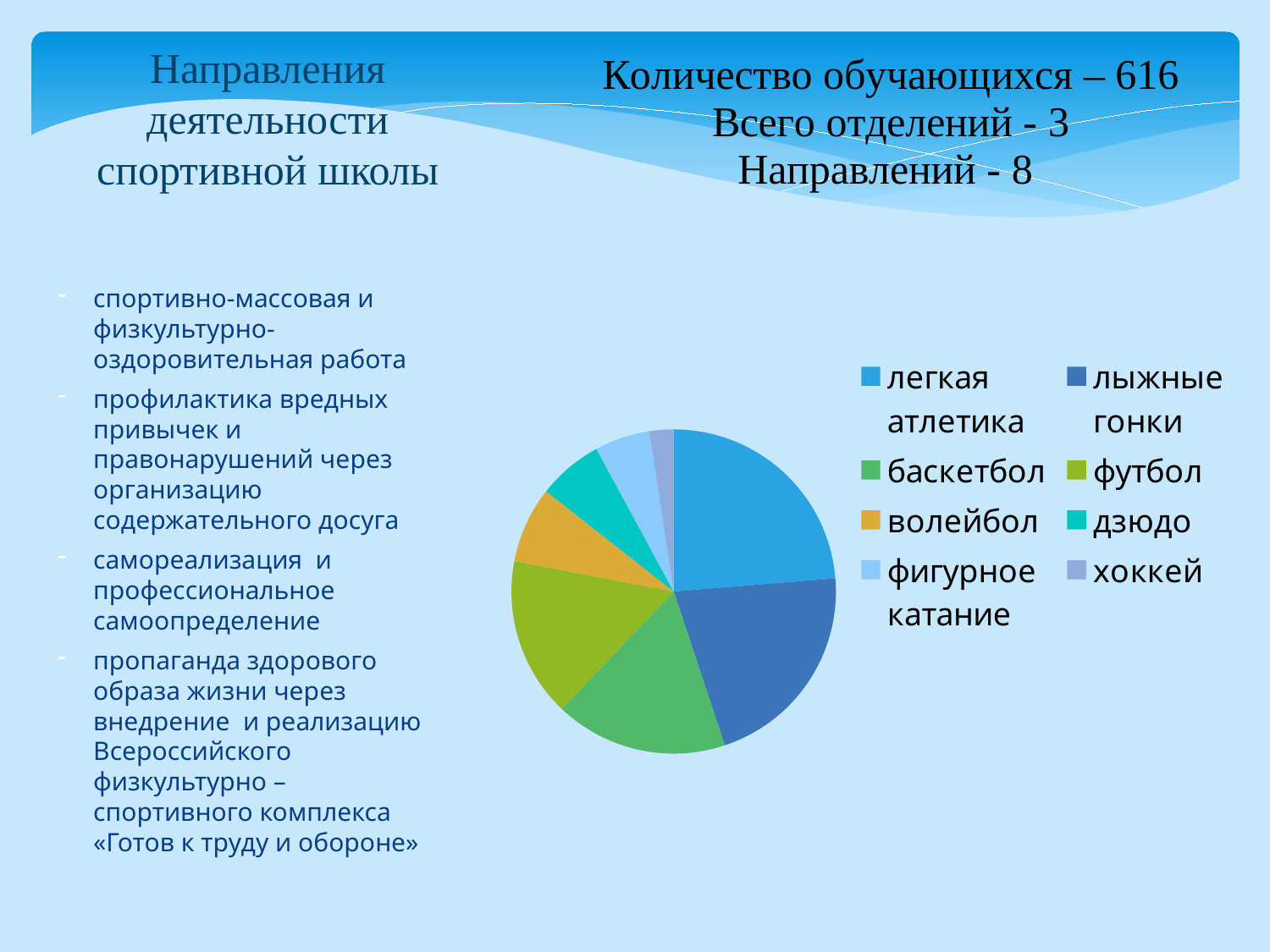
How many categories (slices) does the pie chart have? 8 Which slice is larger in the pie chart: баскетбол or волейбол? баскетбол How many entries does the legend of the pie chart list? 8 Which category has the largest slice in the pie chart? легкая атлетика Which category is shown in green in the pie chart legend? баскетбол Which category has the smallest slice in the pie chart? хоккей Which slice is larger in the pie chart: дзюдо or хоккей? дзюдо Which slice is larger in the pie chart: волейбол or хоккей? волейбол Which category is shown in orange/yellow in the pie chart legend? волейбол What kind of chart is shown on the slide? pie chart